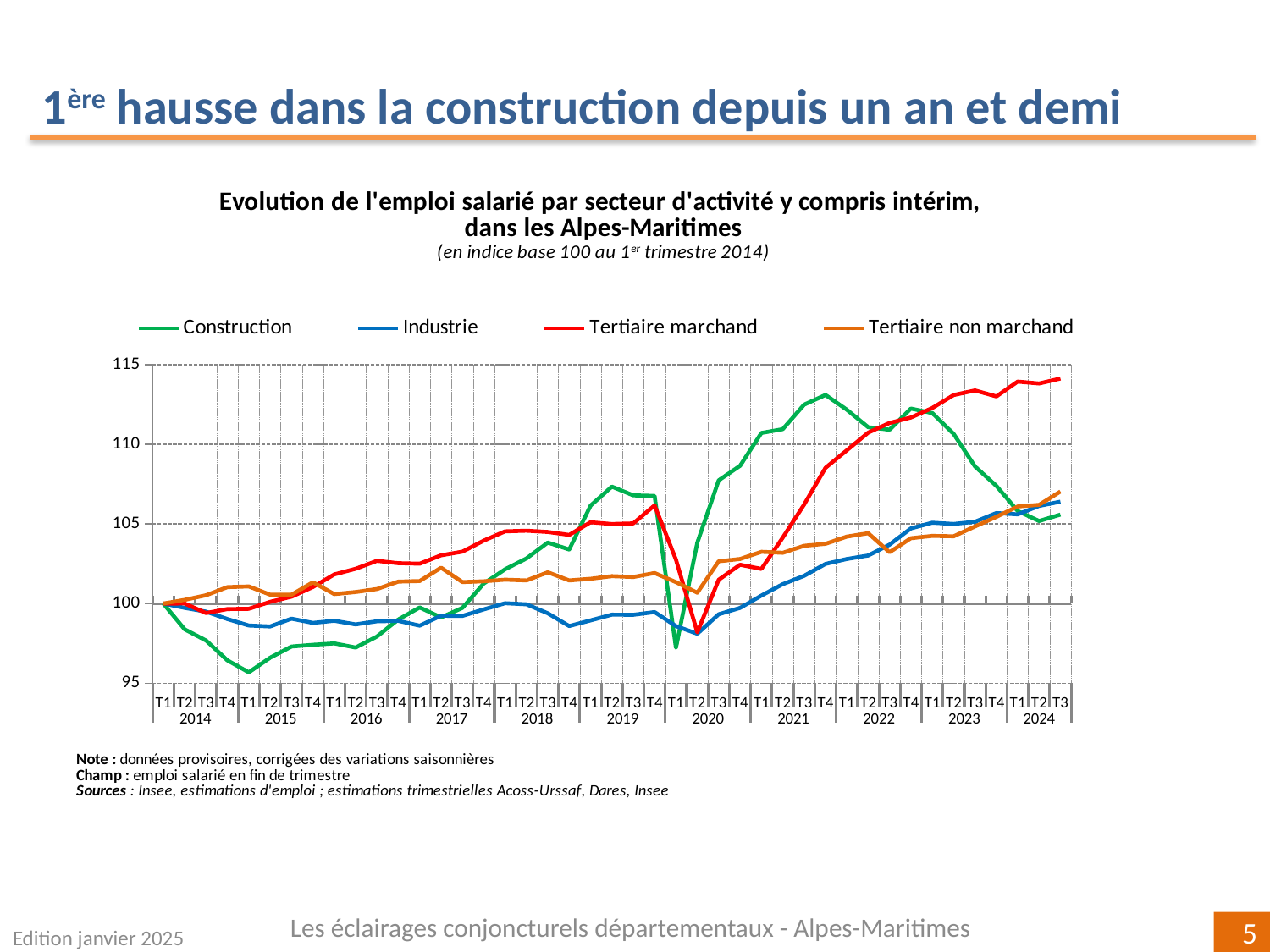
How many series does the legend list? 4 What is the index value of all series at T1 2014? 100 Is the value for Construction at T4 2021 greater or less than 110? greater Which colour is used for the Tertiaire non marchand series? orange Which series has the lowest value at T1 2015? Construction Which series has the highest value at T3 2024? Tertiaire marchand Does the Construction series rise or fall between T4 2021 and T2 2024? fall Is the value for Construction at T1 2015 greater or less than 100? less At T4 2021, which is higher: Construction or Industrie? Construction Is the value for Tertiaire marchand at T3 2024 greater or less than 110? greater What kind of chart is shown on the slide? line chart